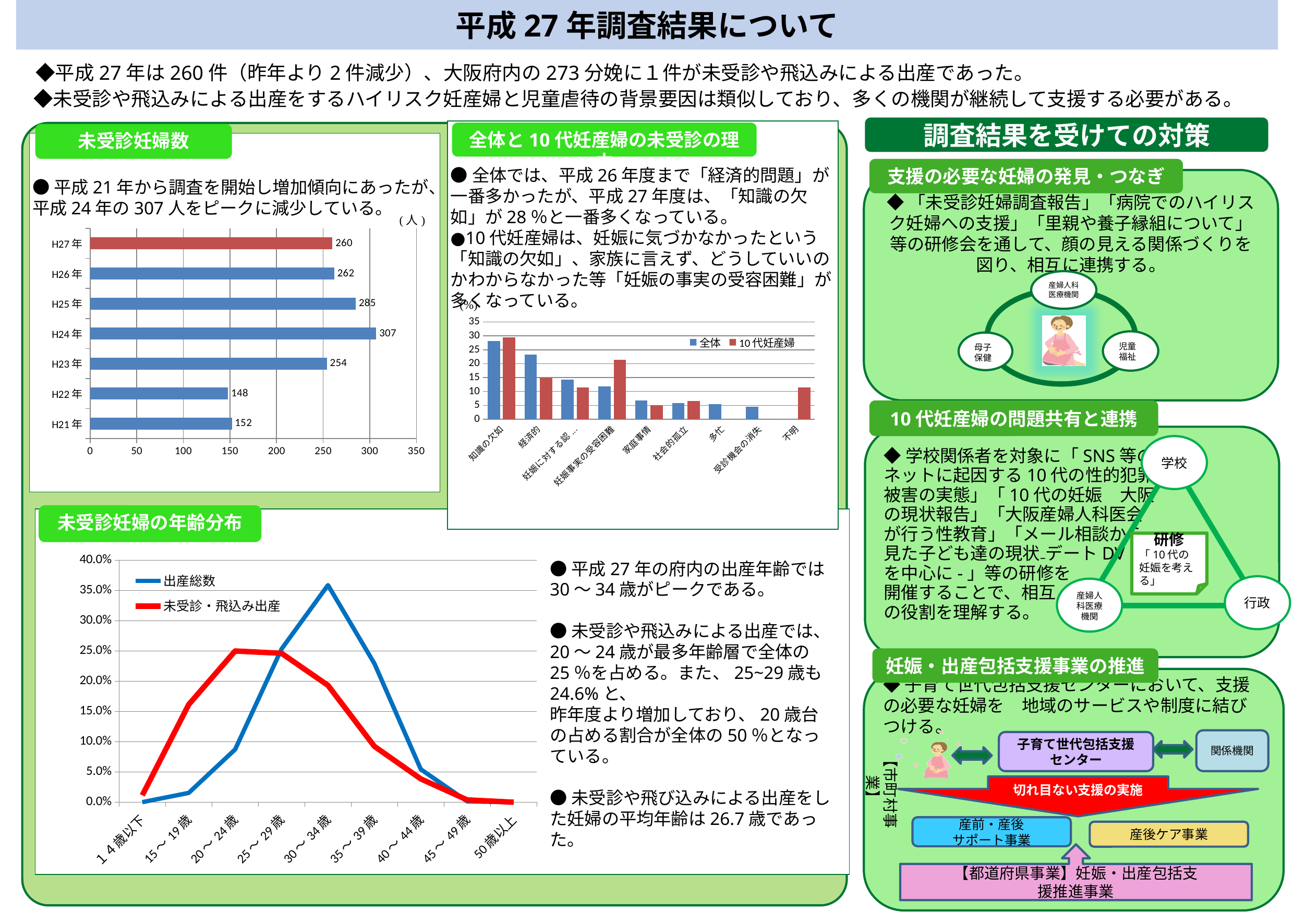
In the 未受診妊婦数 chart, which year has the lowest value? H22年 In the 未受診妊婦の年齢分布 chart, which age group has the highest value for 出産総数? 30～34歳 In the 全体と10代妊産婦の未受診の理由 chart, which series has the larger value for 妊娠事実の受容困難, 全体 or 10代妊産婦? 10代妊産婦 In the 未受診妊婦数 chart, what is the difference between the values for H24年 and H27年? 47 In the 全体と10代妊産婦の未受診の理由 chart, which category has the highest 全体 value? 知識の欠如 In the 未受診妊婦の年齢分布 chart, is the 未受診・飛込み出産 value for 20～24歳 greater or less than 20.0%? greater In the 未受診妊婦数 chart, what is the value for H24年? 307 In the 全体と10代妊産婦の未受診の理由 chart, how many series does the legend list? 2 In the 未受診妊婦数 chart, what is the value for H27年? 260 In the 全体と10代妊産婦の未受診の理由 chart, is the 全体 value for 知識の欠如 greater or less than 25? greater What kind of chart is the 未受診妊婦数 chart? bar chart In the 未受診妊婦数 chart, how many years are shown? 7